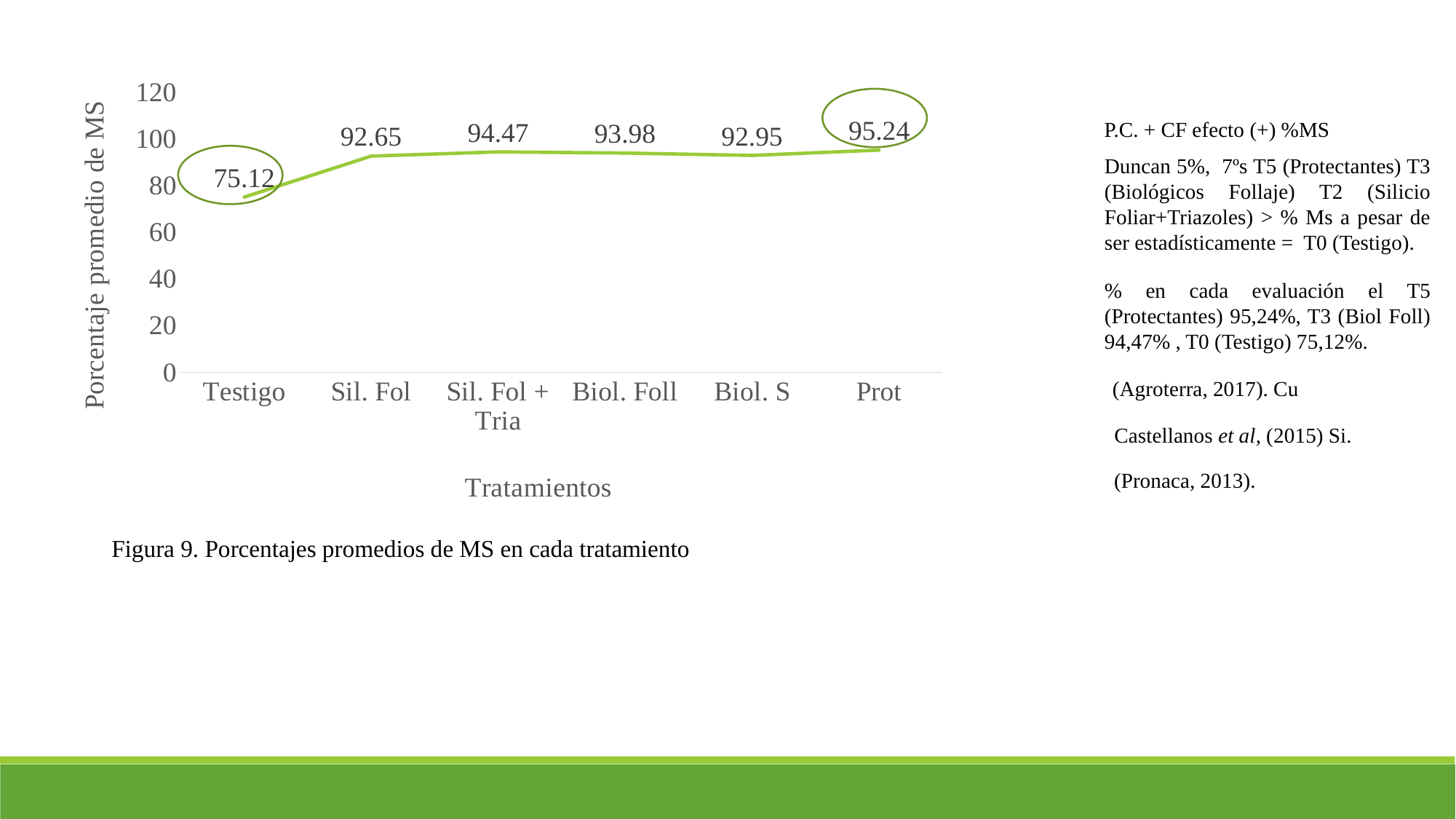
Which is larger, the value for Sil. Fol or the value for Biol. Foll? Biol. Foll How many treatments are plotted on the x axis? 6 What is the value for Prot? 95.24 What is the value for Testigo? 75.12 What is the x-axis title of the chart? Tratamientos What is the value for Sil. Fol + Tria? 94.47 What is the value for Biol. S? 92.95 Is the value for Testigo greater or less than 80? less Which treatment has the highest value? Prot Which treatment has the lowest value? Testigo What is the difference between the values for Prot and Testigo? 20.12 What kind of chart is shown? line chart